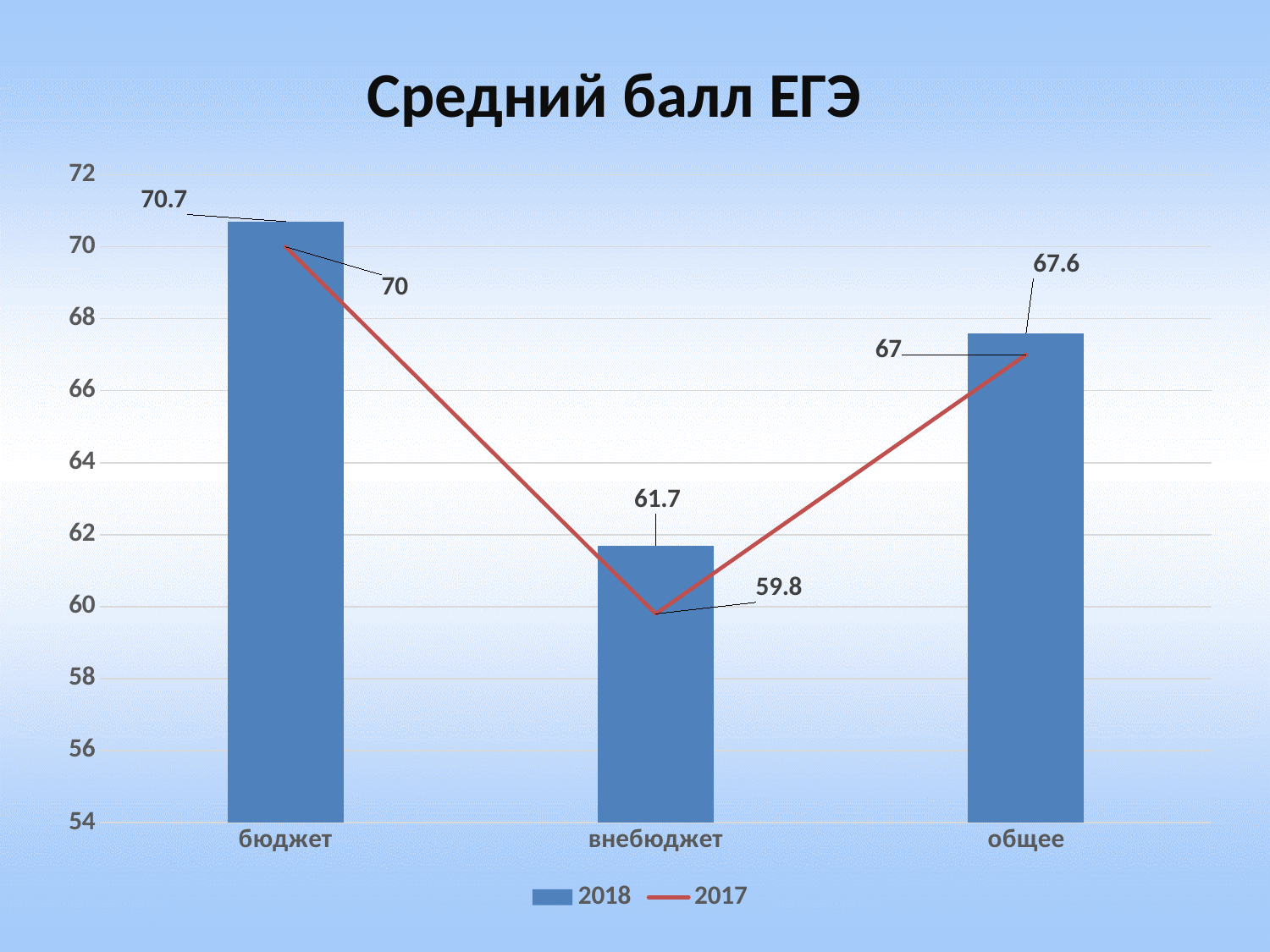
What is the 2018 value for общее? 67.6 What is the title of the chart? Средний балл ЕГЭ How many categories are shown on the x axis? 3 Which category has the lowest 2017 value? внебюджет How many series does the legend list? 2 Which series is drawn as a red line? 2017 Which is larger for общее: the 2018 value or the 2017 value? 2018 What is the difference between the 2018 and 2017 values for внебюджет? 1.9 Which category has the highest 2018 value? бюджет What is the 2017 value for внебюджет? 59.8 What is the 2017 value for бюджет? 70 What is the 2018 value for бюджет? 70.7